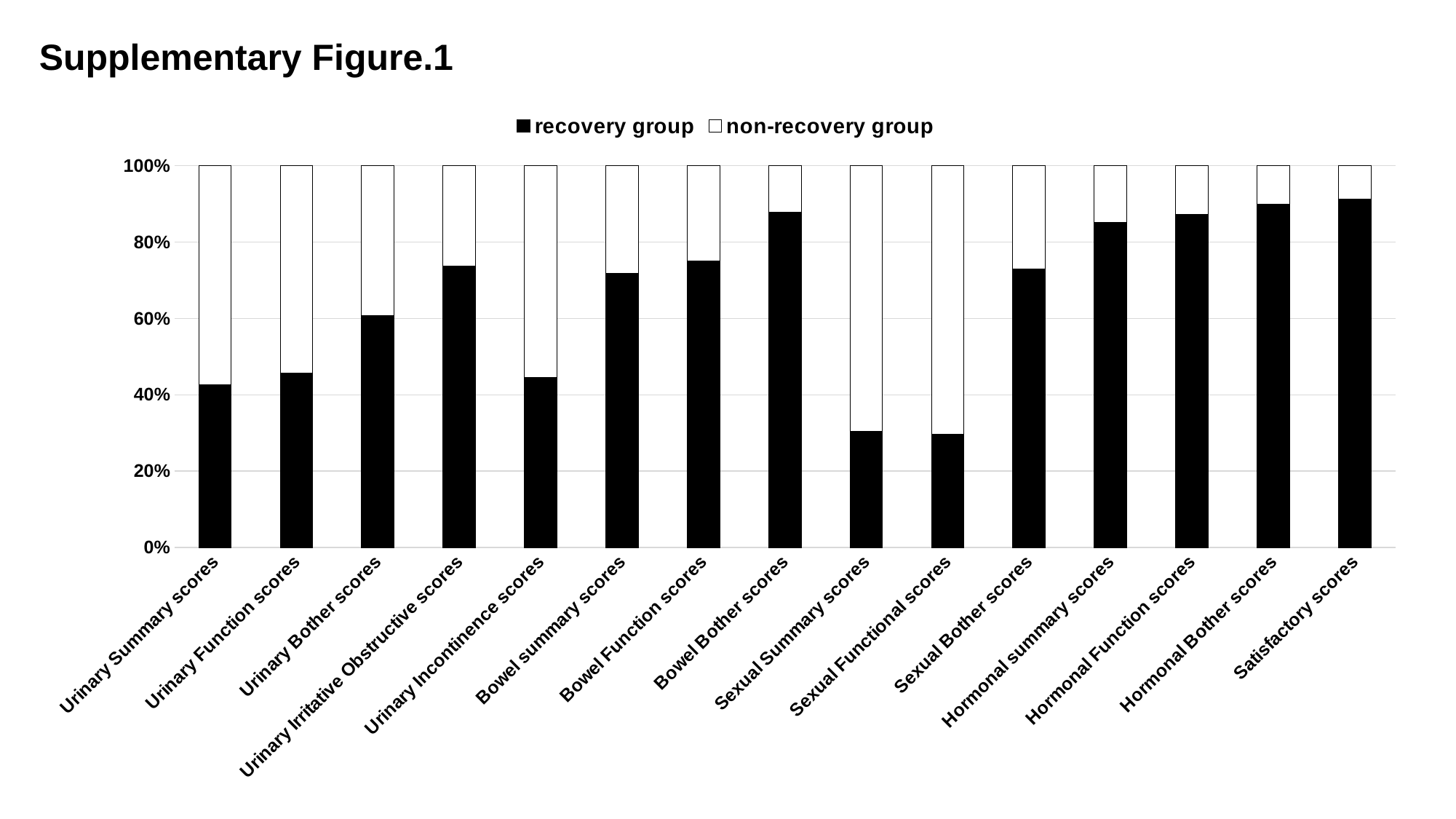
How many categories are shown along the x axis? 15 What is the title shown above the chart on the slide? Supplementary Figure.1 Is the recovery group value for Urinary Irritative Obstructive scores greater or less than 60%? greater Which has the larger non-recovery group share: Urinary Function scores or Urinary Bother scores? Urinary Function scores What kind of chart is shown on the slide? Stacked bar chart Which has the larger recovery group share: Bowel Bother scores or Urinary Summary scores? Bowel Bother scores Is the recovery group value for Bowel Bother scores greater or less than 80%? greater How many series does the legend list? 2 Which series is drawn in black? recovery group Is the recovery group value for Sexual Summary scores greater or less than 40%? less Which has the larger recovery group share: Sexual Summary scores or Hormonal summary scores? Hormonal summary scores